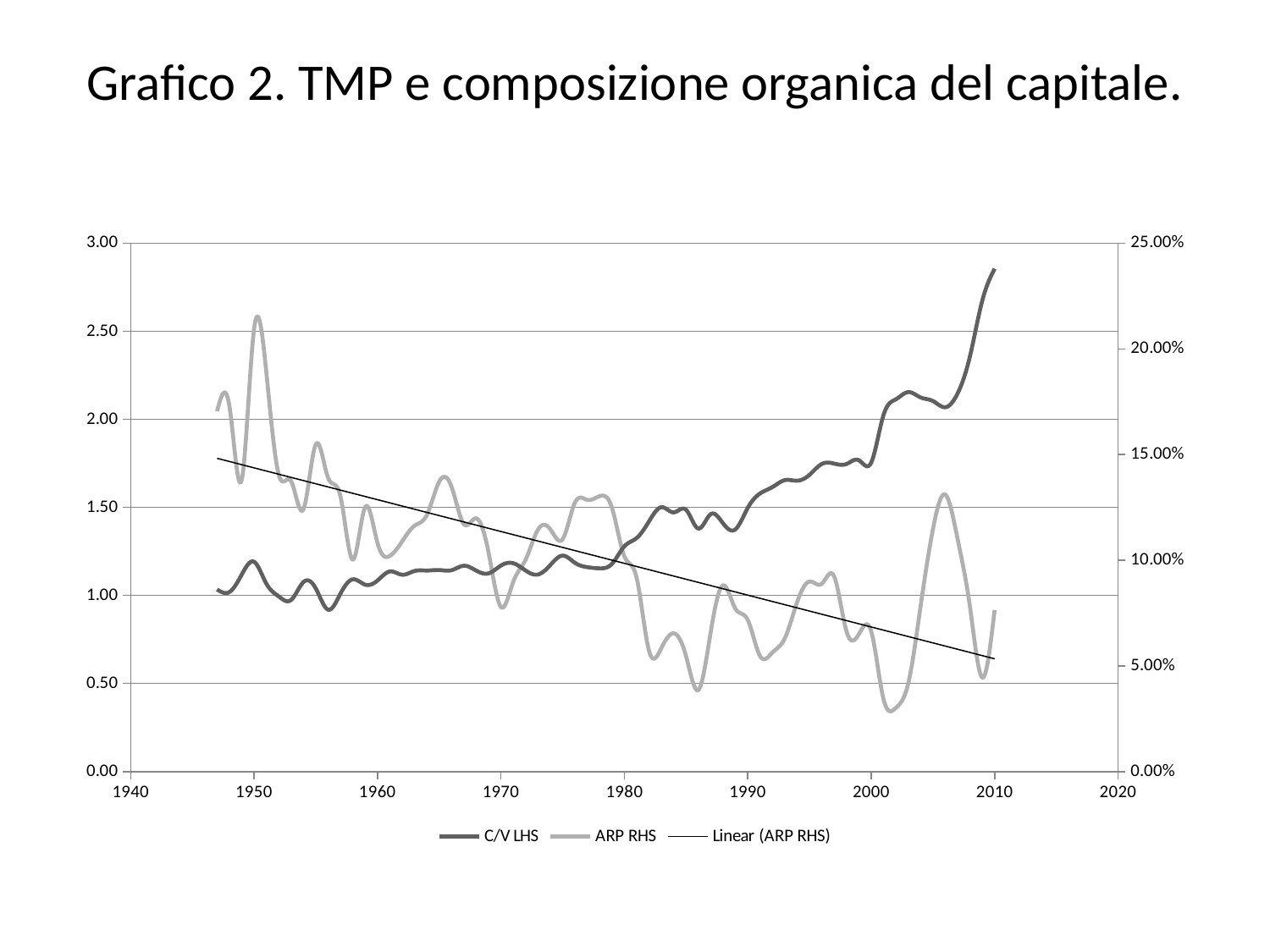
Is the value of the Linear (ARP RHS) trendline at 2010 greater or less than 10.00%? less What is the title of the chart? Grafico 2. TMP e composizione organica del capitale. Is the value of C/V LHS at 1960 greater or less than 1.50? less Which series is plotted against the right-hand axis? ARP RHS Does the C/V LHS series generally rise or fall from 1950 to 2010? rise How many entries does the legend list? 3 Does the Linear (ARP RHS) trendline rise or fall from left to right? fall Is the peak value of ARP RHS around 1950 greater or less than 20.00%? greater Does the ARP RHS series generally rise or fall between 1950 and 2010? fall What kind of chart is shown on the slide? line chart